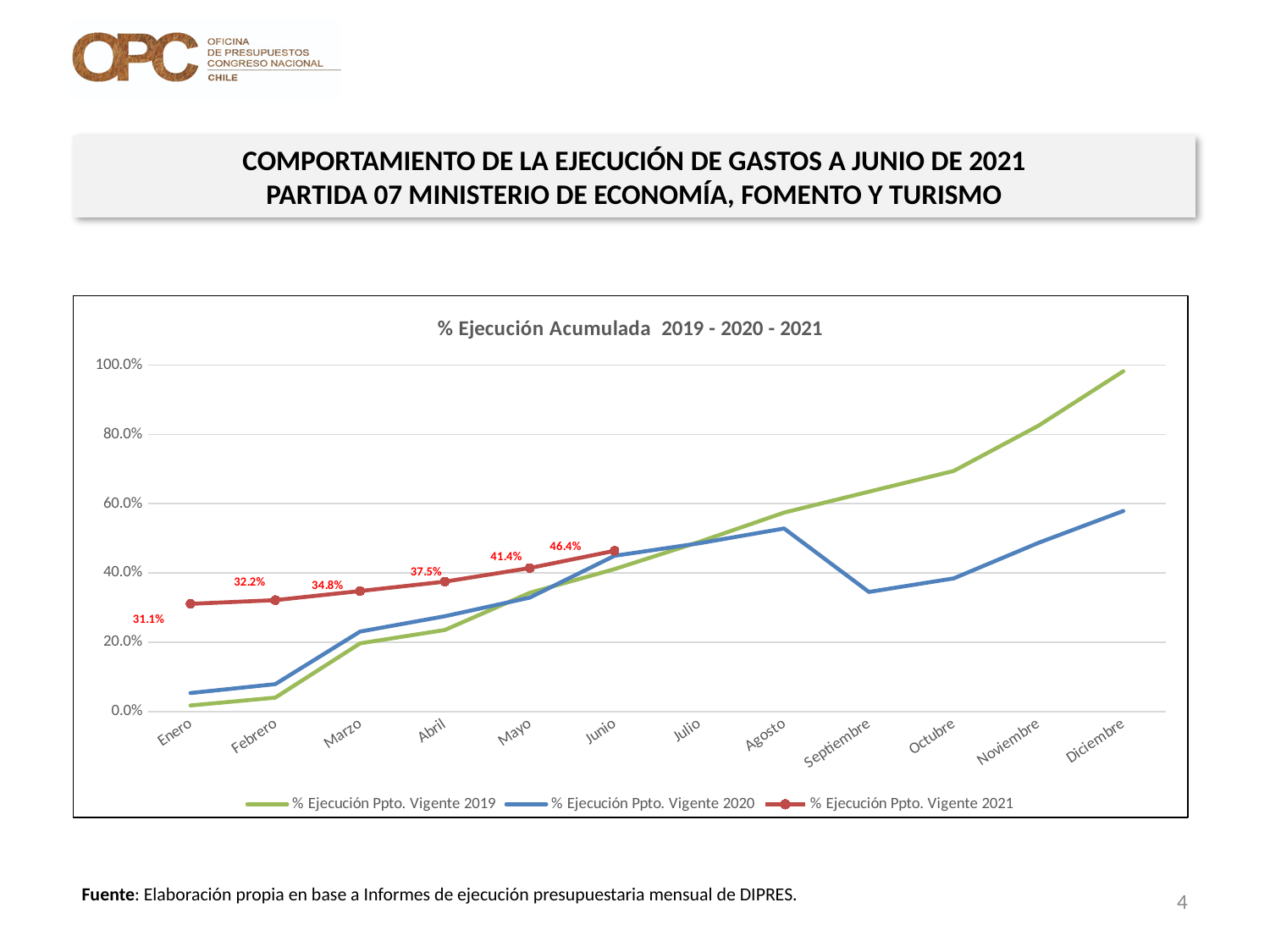
Which month has the highest labelled value for % Ejecución Ppto. Vigente 2021? Junio What is the value for % Ejecución Ppto. Vigente 2021 in Junio? 46.4% How many series does the legend list? 3 What is the difference between the 2021 values for Junio and Enero? 15.3 percentage points Which month has the lowest labelled value for % Ejecución Ppto. Vigente 2021? Enero What is the value for % Ejecución Ppto. Vigente 2021 in Abril? 37.5% What is the value for % Ejecución Ppto. Vigente 2021 in Enero? 31.1% In Diciembre, which is larger: % Ejecución Ppto. Vigente 2019 or % Ejecución Ppto. Vigente 2020? % Ejecución Ppto. Vigente 2019 How many months are shown on the x axis? 12 Is the value for % Ejecución Ppto. Vigente 2019 in Diciembre greater or less than 80%? greater Does the % Ejecución Ppto. Vigente 2021 line rise or fall from Enero to Junio? Rise What kind of chart is shown on the slide? Line chart